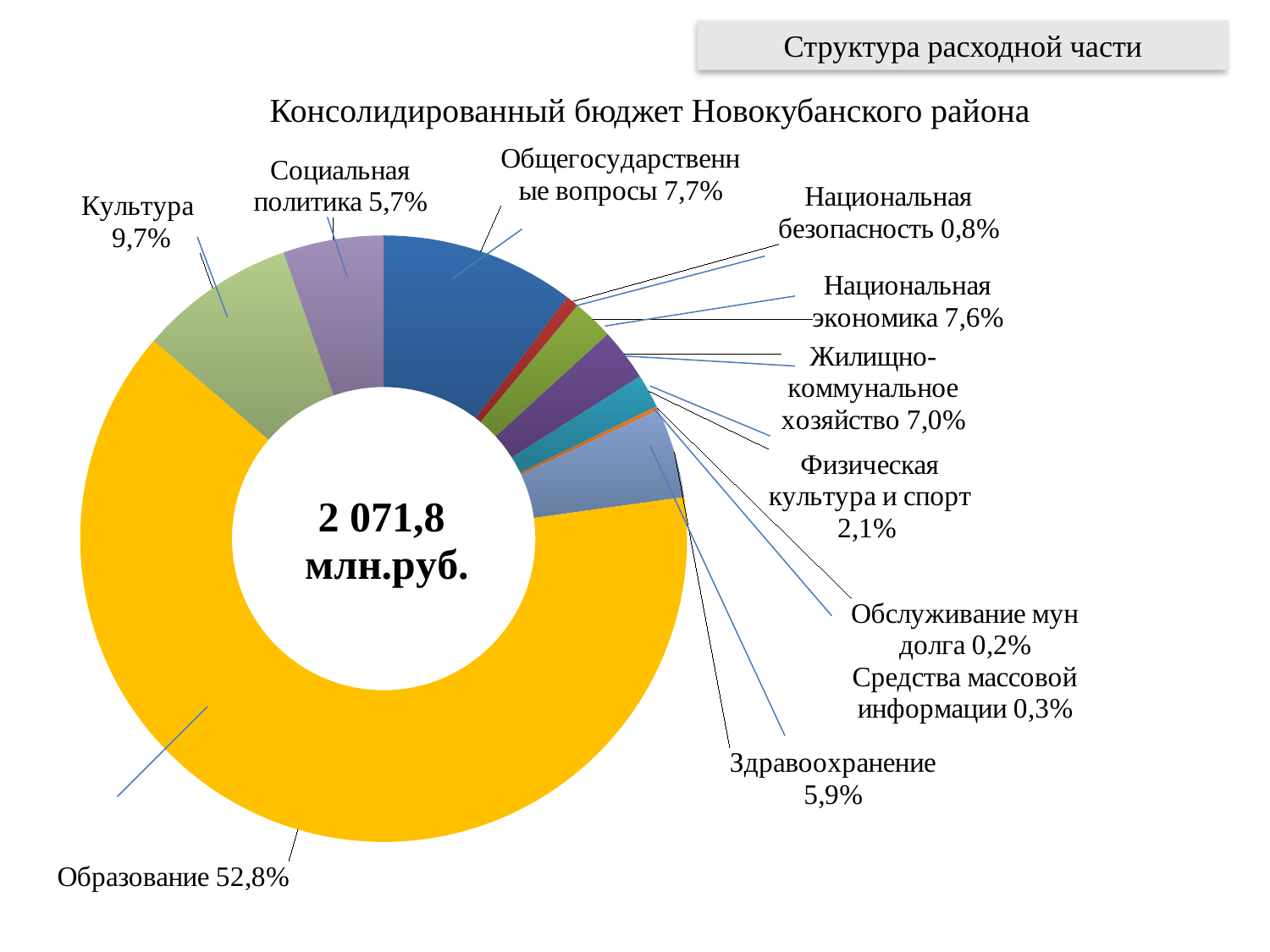
Which category has the largest share of the chart? Образование What kind of chart is shown on the slide? Doughnut (pie) chart Which is larger, the share for Культура or the share for Социальная политика? Культура What is the difference between the shares of Общегосударственные вопросы and Национальная экономика? 0,1% What is the title of the chart? Консолидированный бюджет Новокубанского района What is the value shown for Культура? 9,7% What is the value shown for Жилищно-коммунальное хозяйство? 7,0% What total amount is printed in the centre of the chart? 2 071,8 млн.руб. How many categories are shown in the chart? 11 What is the value shown for Здравоохранение? 5,9% What share of the chart does Образование account for? 52,8% Which category has the smallest share of the chart? Обслуживание мун долга